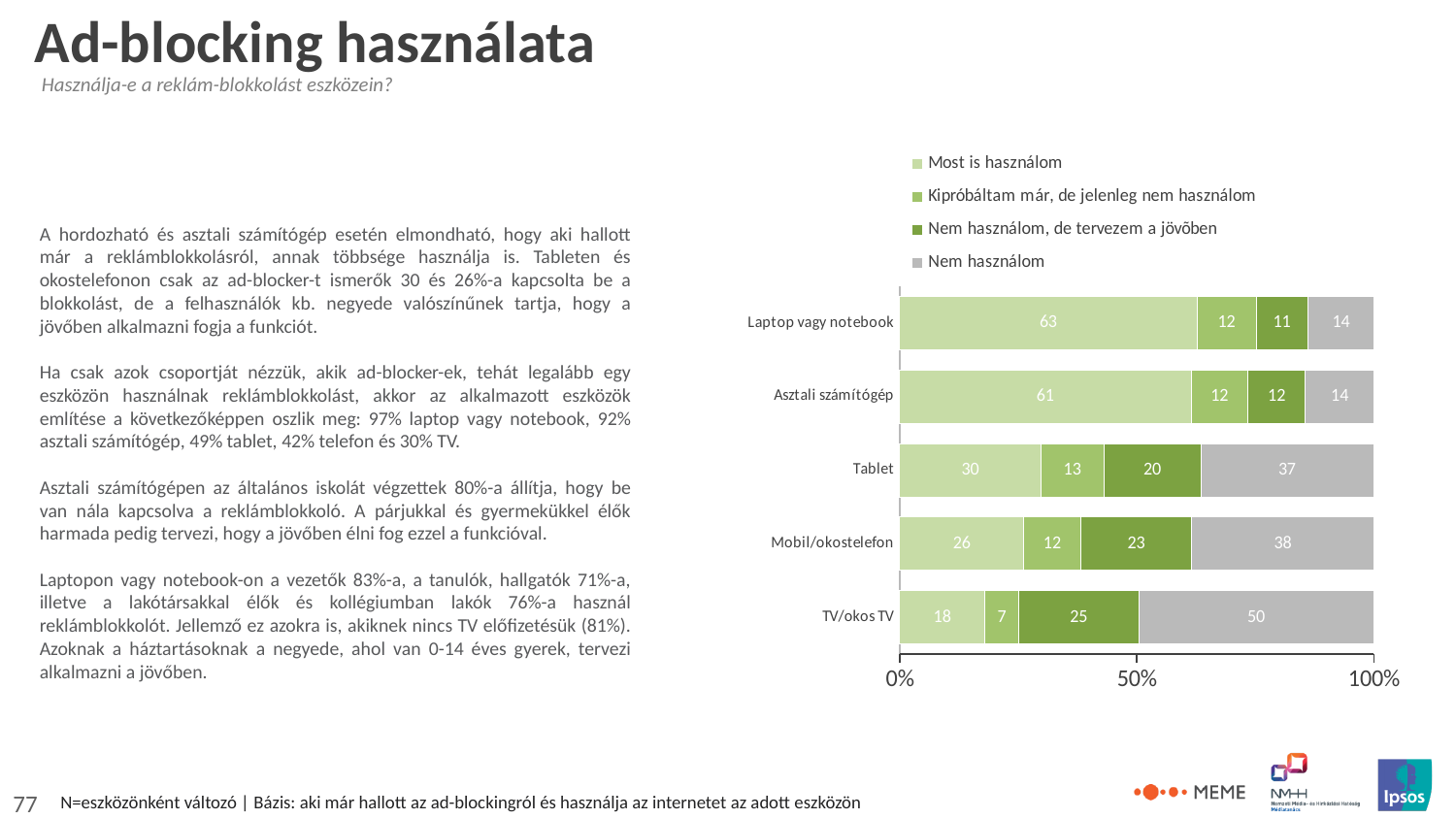
Which category has the lowest value for "Most is használom"? TV/okos TV What kind of chart is shown on the slide? Stacked bar chart Which category has the highest value for "Most is használom"? Laptop vagy notebook What is the value of "Kipróbáltam már, de jelenleg nem használom" for TV/okos TV? 7 What is the first entry in the chart's legend? Most is használom What is the value of "Nem használom" for TV/okos TV? 50 How many series does the legend list? 4 What is the difference between the "Nem használom" values for Tablet and Laptop vagy notebook? 23 What is the value of "Most is használom" for Laptop vagy notebook? 63 How many categories (devices) are shown in the chart? 5 Which has the larger value for "Nem használom, de tervezem a jövőben": Mobil/okostelefon or Tablet? Mobil/okostelefon What is the total of the stacked bar for Tablet? 100